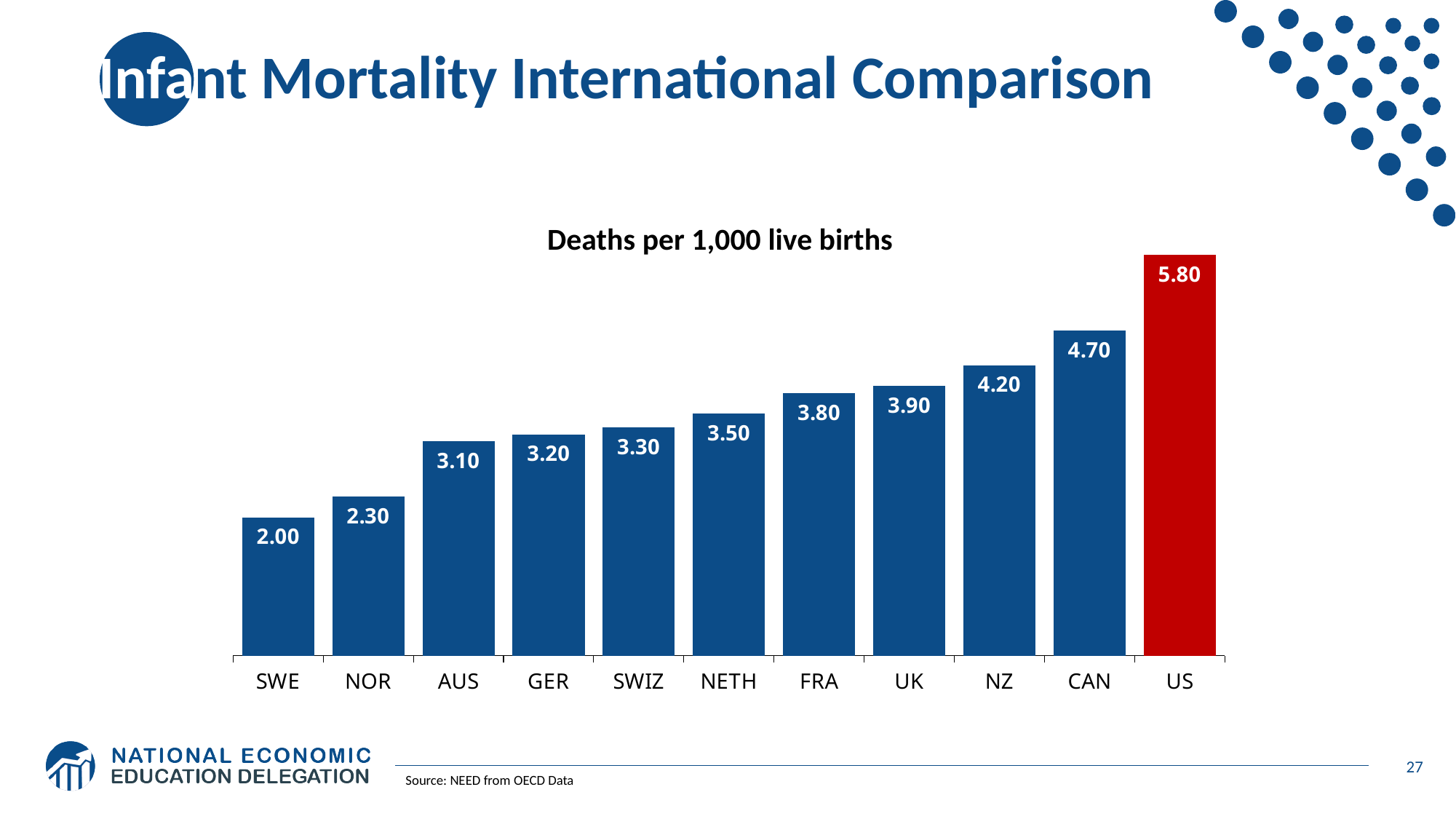
How many countries are shown in the chart? 11 What is the value for NETH in the chart? 3.50 What kind of chart is shown on the slide? Bar chart What is the value for the US in the chart? 5.80 Which country has the highest value in the chart? US What is the difference between the values for NOR and SWE? 0.30 What is the title of the chart? Deaths per 1,000 live births Do the values rise or fall from left to right across the chart? Rise Which country has the lowest value in the chart? SWE What is the difference between the values for the US and CAN? 1.10 What is the value for GER in the chart? 3.20 Which has a larger value, UK or FRA? UK